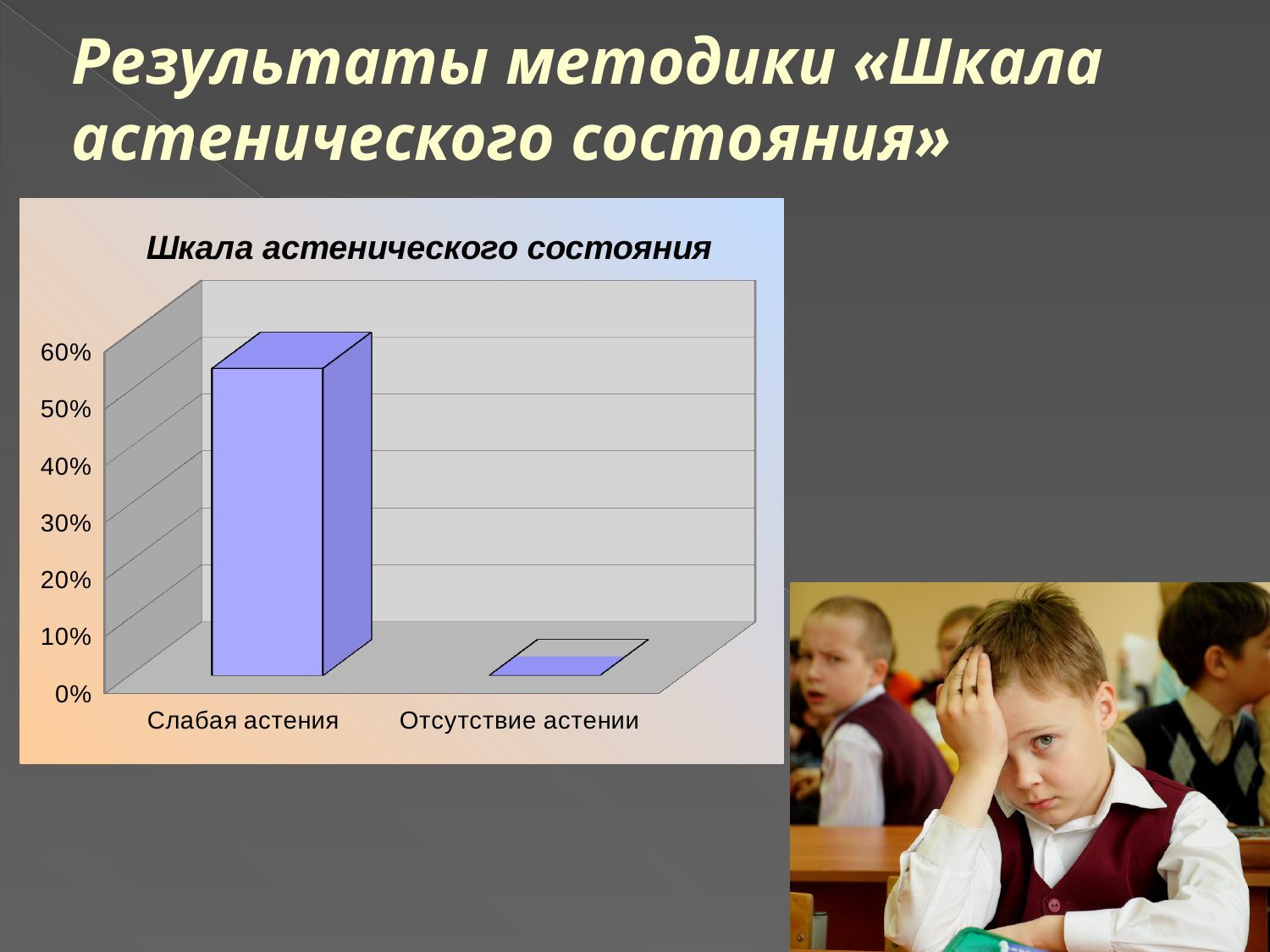
What is the highest value shown on the vertical axis of the chart? 60% What kind of chart is shown on the slide? bar chart Which category has the highest value? Слабая астения Is the value for Отсутствие астении greater or less than 20%? less Is the value for Слабая астения greater or less than 50%? greater Which is larger, the value for Слабая астения or the value for Отсутствие астении? Слабая астения What is the title of the chart? Шкала астенического состояния Is the value for Отсутствие астении greater or less than 10%? less How many categories are shown on the chart? 2 Which category has the lowest value? Отсутствие астении